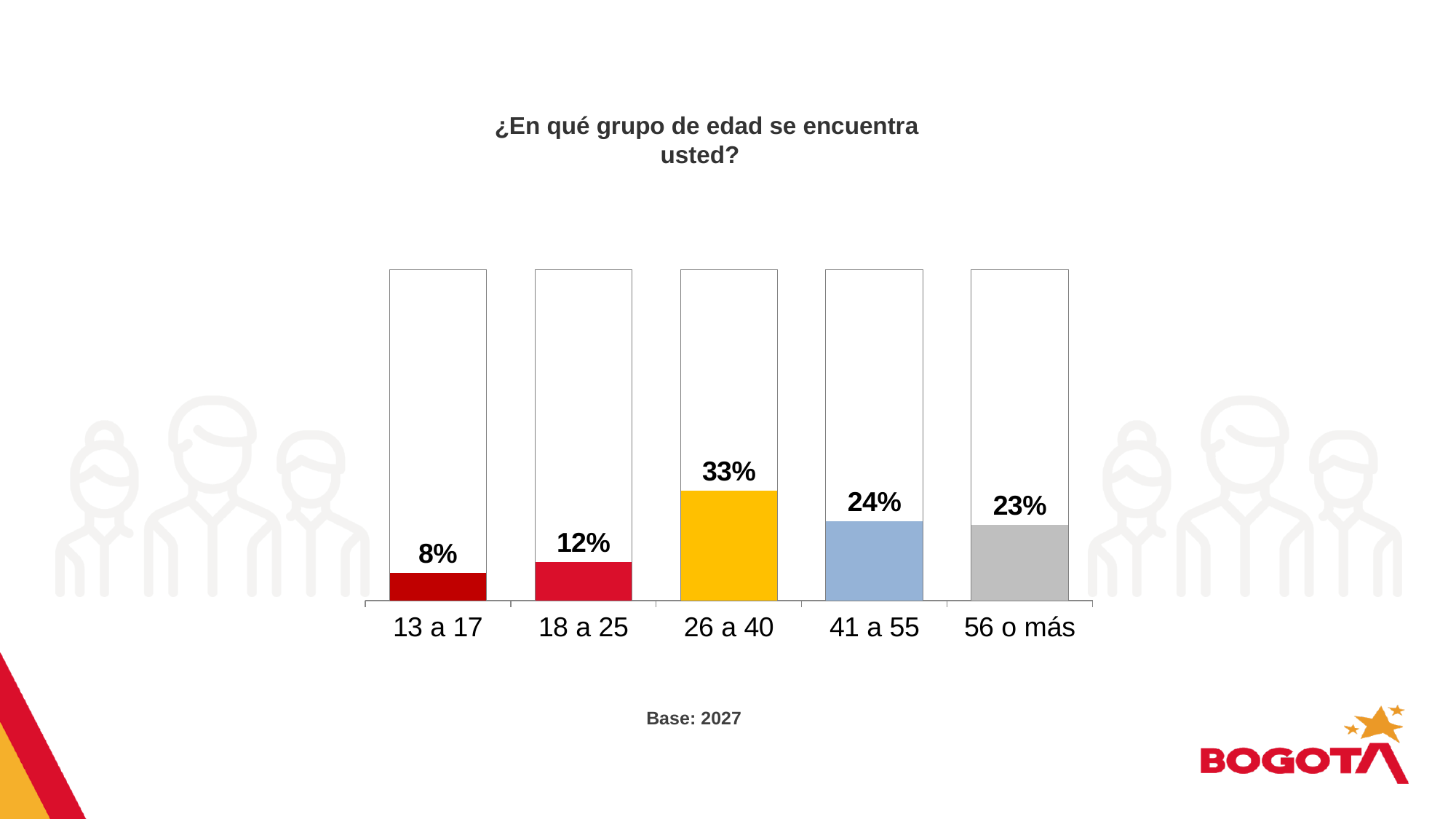
What kind of chart is shown on the slide? Bar chart What is the difference in percentage points between the 26 a 40 and 18 a 25 age groups? 21 How many age groups are shown in the chart? 5 What is the title of the chart? ¿En qué grupo de edad se encuentra usted? Which age group has a larger percentage, 18 a 25 or 41 a 55? 41 a 55 What is the difference in percentage points between the 41 a 55 and 56 o más age groups? 1 Which age group has the lowest percentage? 13 a 17 What percentage of respondents are in the 26 a 40 age group? 33% What percentage of respondents are in the 56 o más age group? 23% What percentage of respondents are in the 13 a 17 age group? 8% Which age group has the highest percentage? 26 a 40 What is the base (number of respondents) stated below the chart? 2027